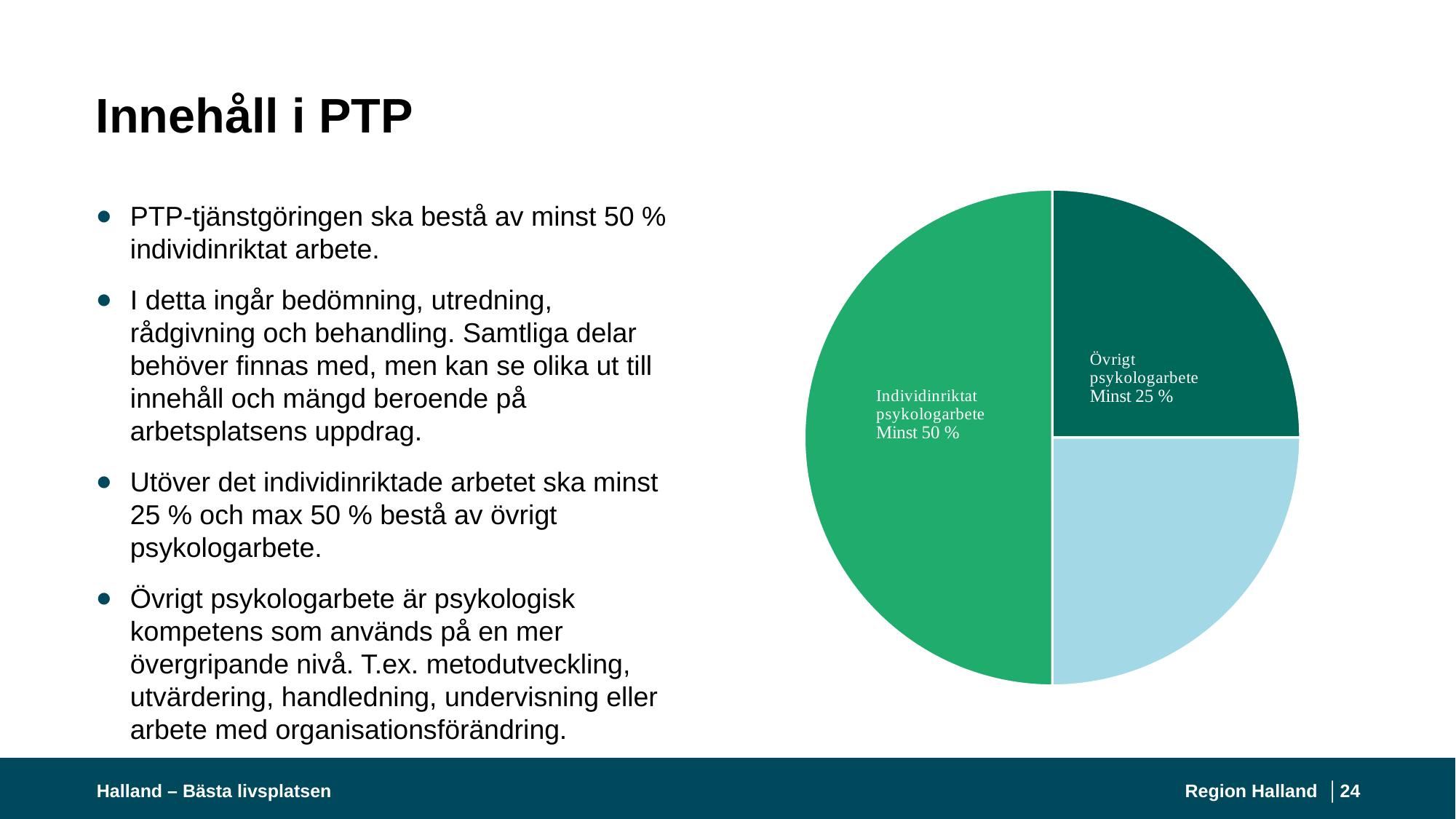
Is the unlabelled light blue slice larger or smaller than the "Individinriktat psykologarbete" slice? Smaller What colour is the slice labelled "Övrigt psykologarbete"? Dark teal green How many slices of the pie chart carry a text label? 2 Which slice of the pie chart is the largest? Individinriktat psykologarbete What colour is the slice labelled "Individinriktat psykologarbete"? Green How many slices does the pie chart have? 3 What share is printed on the slice labelled "Individinriktat psykologarbete"? Minst 50 % What share is printed on the slice labelled "Övrigt psykologarbete"? Minst 25 % Which is larger in the pie chart: the "Individinriktat psykologarbete" slice or the "Övrigt psykologarbete" slice? Individinriktat psykologarbete What kind of chart is shown on the slide? Pie chart